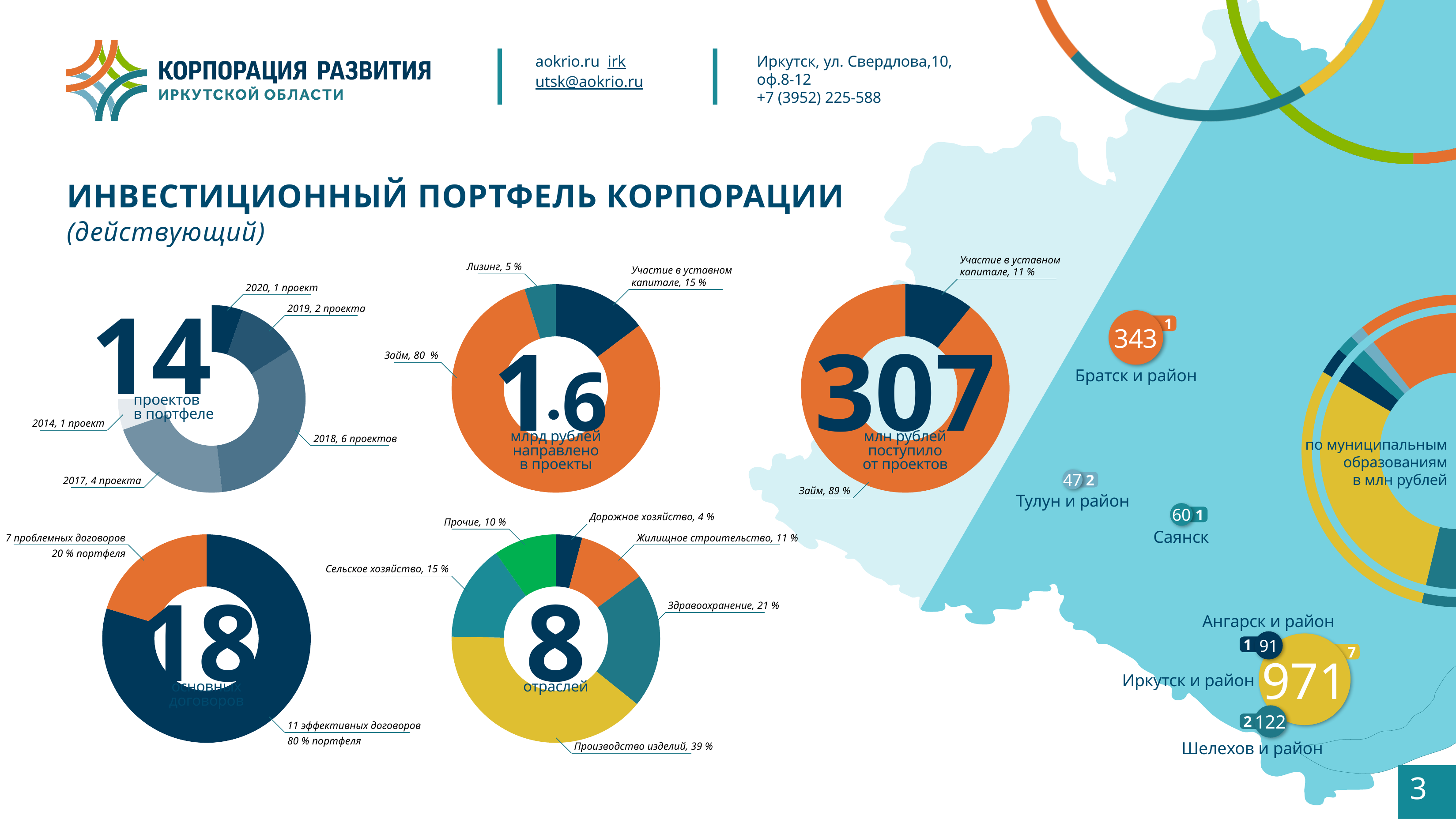
In the donut chart with "1.6 млрд рублей направлено в проекты" in the centre, what share is labelled for Займ? 80 % In the donut chart with "14 проектов в портфеле" in the centre, how many more projects does 2018 have than 2017? 2 In the donut chart with "1.6 млрд рублей направлено в проекты" in the centre, which category has the smallest share? Лизинг In the donut chart with "14 проектов в портфеле" in the centre, how many projects are shown for 2018? 6 проектов In the donut chart with "14 проектов в портфеле" in the centre, which year has the most projects? 2018 In the donut chart with "8 отраслей" in the centre, which sector has the largest share? Производство изделий In the donut chart with "307 млн рублей поступило от проектов" in the centre, what is the difference between the Займ share and the Участие в уставном капитале share? 78 % What type of chart is used for the "8 отраслей" breakdown? Donut (pie) chart In the donut chart with "14 проектов в портфеле" in the centre, how many year categories are labelled? 5 In the donut chart with "307 млн рублей поступило от проектов" in the centre, what share is labelled for Участие в уставном капитале? 11 % In the donut chart with "18 основных договоров" in the centre, what share of the portfolio do the 11 эффективных договоров make up? 80 % In the donut chart with "8 отраслей" in the centre, which is larger: Здравоохранение or Сельское хозяйство? Здравоохранение